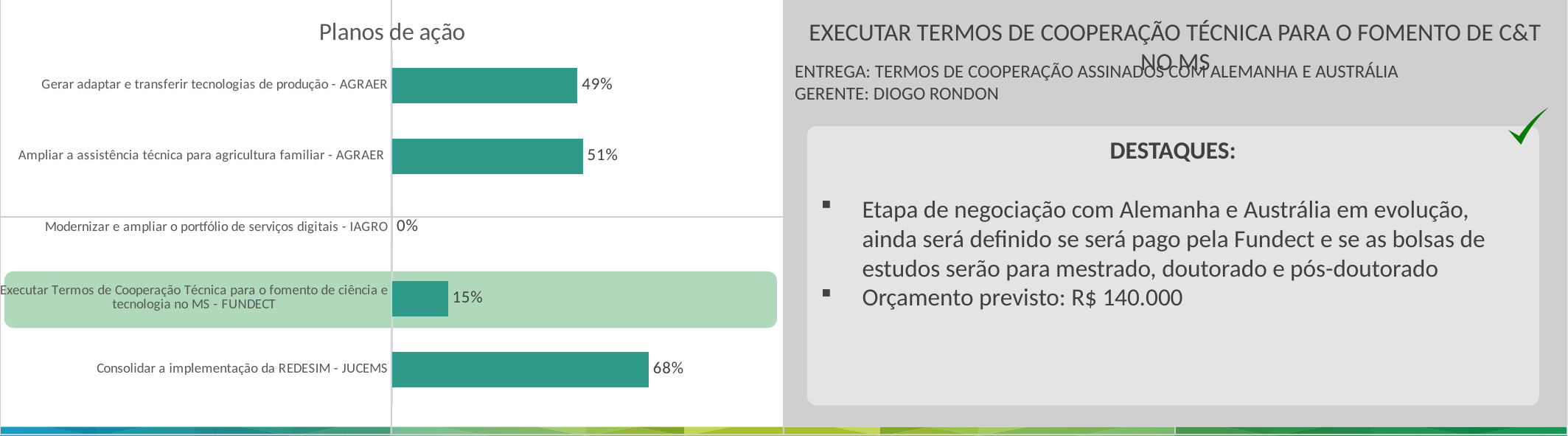
What is the value for 'Consolidar a implementação da REDESIM - JUCEMS' in the 'Planos de ação' chart? 68% How many categories are shown in the 'Planos de ação' chart? 5 Which category has the highest value in the 'Planos de ação' chart? Consolidar a implementação da REDESIM - JUCEMS What is the value for 'Executar Termos de Cooperação Técnica para o fomento de ciência e tecnologia no MS - FUNDECT' in the 'Planos de ação' chart? 15% Which category has the lowest value in the 'Planos de ação' chart? Modernizar e ampliar o portfólio de serviços digitais - IAGRO What is the value for 'Modernizar e ampliar o portfólio de serviços digitais - IAGRO' in the 'Planos de ação' chart? 0% In the 'Planos de ação' chart, which is larger: the value for 'Ampliar a assistência técnica para agricultura familiar - AGRAER' or 'Gerar adaptar e transferir tecnologias de produção - AGRAER'? Ampliar a assistência técnica para agricultura familiar - AGRAER In the 'Planos de ação' chart, what is the difference between the values for 'Consolidar a implementação da REDESIM - JUCEMS' and 'Ampliar a assistência técnica para agricultura familiar - AGRAER'? 17% In the 'Planos de ação' chart, what is the difference between the values for 'Ampliar a assistência técnica para agricultura familiar - AGRAER' and 'Executar Termos de Cooperação Técnica para o fomento de ciência e tecnologia no MS - FUNDECT'? 36% What is the title of the chart on the left of the slide? Planos de ação What is the value for 'Gerar adaptar e transferir tecnologias de produção - AGRAER' in the 'Planos de ação' chart? 49% What kind of chart is the 'Planos de ação' chart? Bar chart